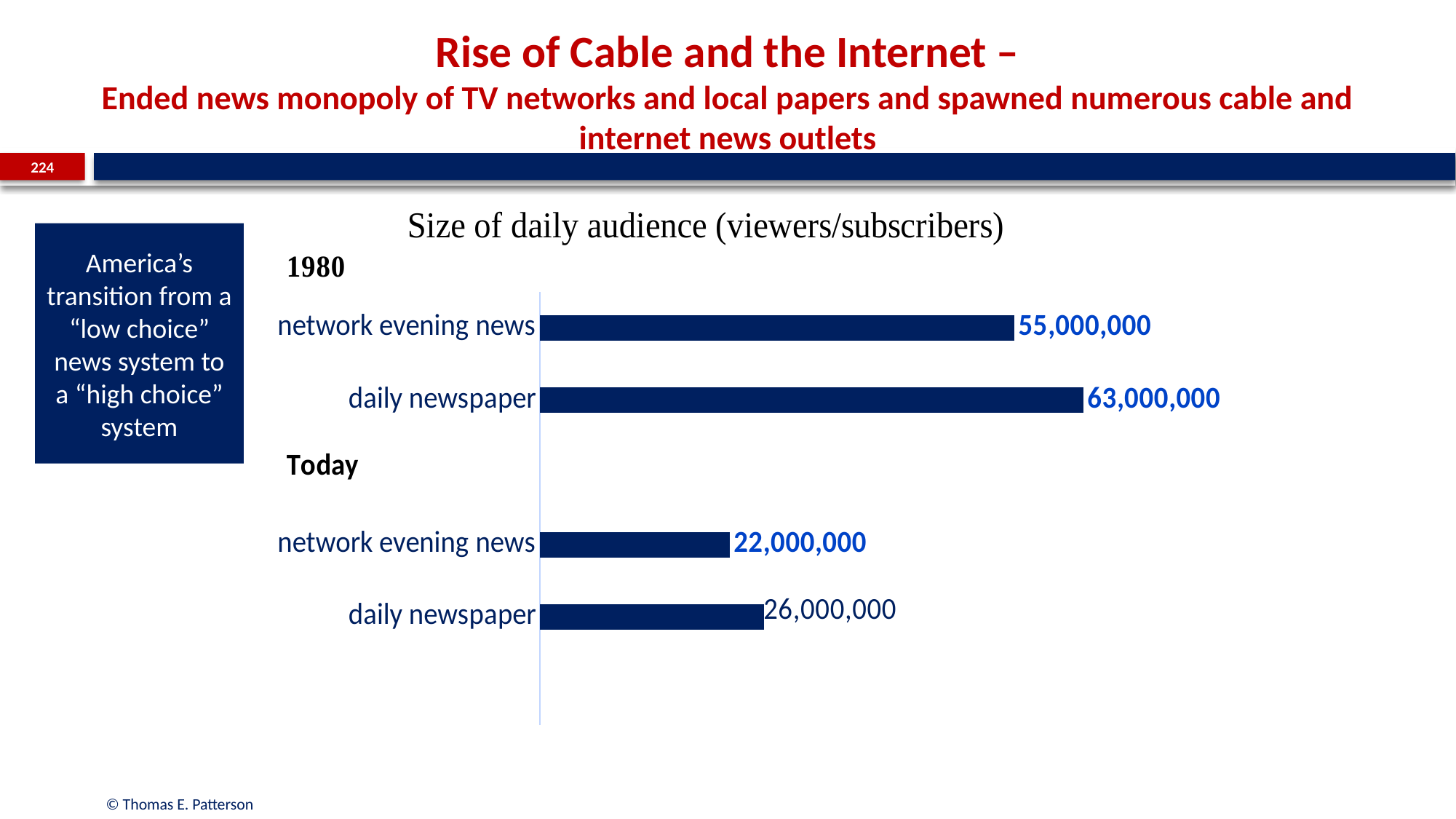
What is the size of the daily audience for daily newspaper in 1980? 63,000,000 Which bar has the smallest daily audience? network evening news (Today) What is the size of the daily audience for daily newspaper today? 26,000,000 What is the difference between the daily newspaper audience in 1980 and today? 37,000,000 How many bars are plotted in the chart? 4 Which bar has the largest daily audience? daily newspaper (1980) What is the difference between the network evening news audience in 1980 and today? 33,000,000 What is the title of the chart? Size of daily audience (viewers/subscribers) What is the size of the daily audience for network evening news in 1980? 55,000,000 What is the size of the daily audience for network evening news today? 22,000,000 What kind of chart is shown on the slide? bar chart Which is larger, the 1980 network evening news audience or the 1980 daily newspaper audience? daily newspaper